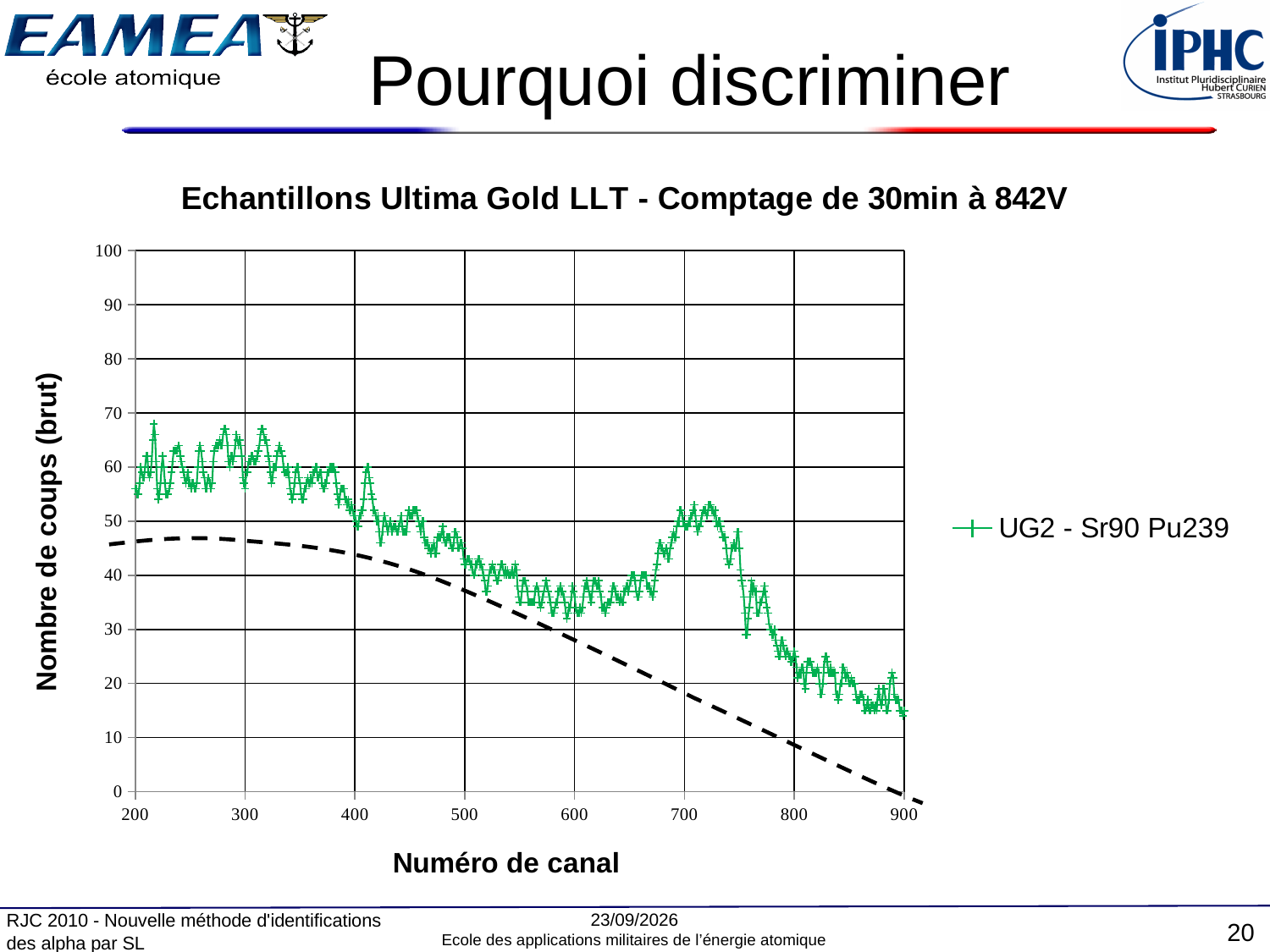
Is the value for UG2 - Sr90 Pu239 at channel 600 greater or less than 50? less Is the value for UG2 - Sr90 Pu239 at channel 800 greater or less than 30? less What is the name of the series listed in the legend? UG2 - Sr90 Pu239 Is the value for UG2 - Sr90 Pu239 at channel 900 greater or less than 20? less What kind of chart is shown on the slide? line chart Overall, do the values of UG2 - Sr90 Pu239 rise or fall as the channel number increases from 200 to 900? fall Is the value for UG2 - Sr90 Pu239 at channel 300 larger or smaller than the value at channel 800? larger What is the title of the chart? Echantillons Ultima Gold LLT - Comptage de 30min à 842V How many series does the legend list? 1